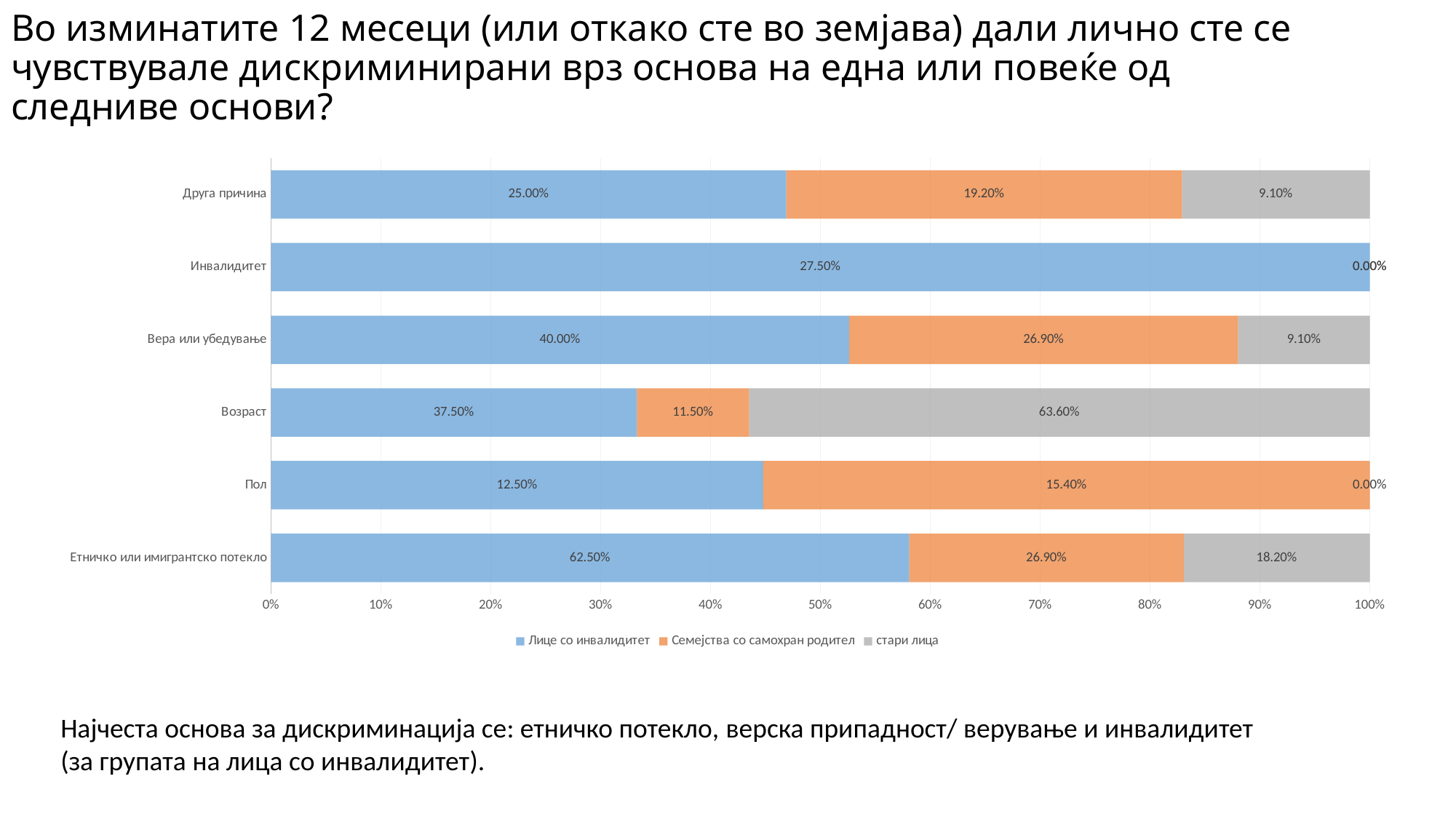
Which colour represents the стари лица series? Grey What kind of chart is shown on the slide? Stacked bar chart What is the value for Семејства со самохран родител in the Друга причина category? 19.20% What is the value for стари лица in the Возраст category? 63.60% What is the value for Лице со инвалидитет in the Инвалидитет category? 27.50% How many categories are shown on the vertical axis? 6 What is the value for Лице со инвалидитет in the Етничко или имигрантско потекло category? 62.50% How many series does the legend list? 3 What is the difference between the Лице со инвалидитет values for Вера или убедување and Возраст? 2.50% Which is larger: the Семејства со самохран родител value for Пол or for Возраст? Пол Which category has the highest value for the Лице со инвалидитет series? Етничко или имигрантско потекло Which category has the lowest value for the Лице со инвалидитет series? Пол